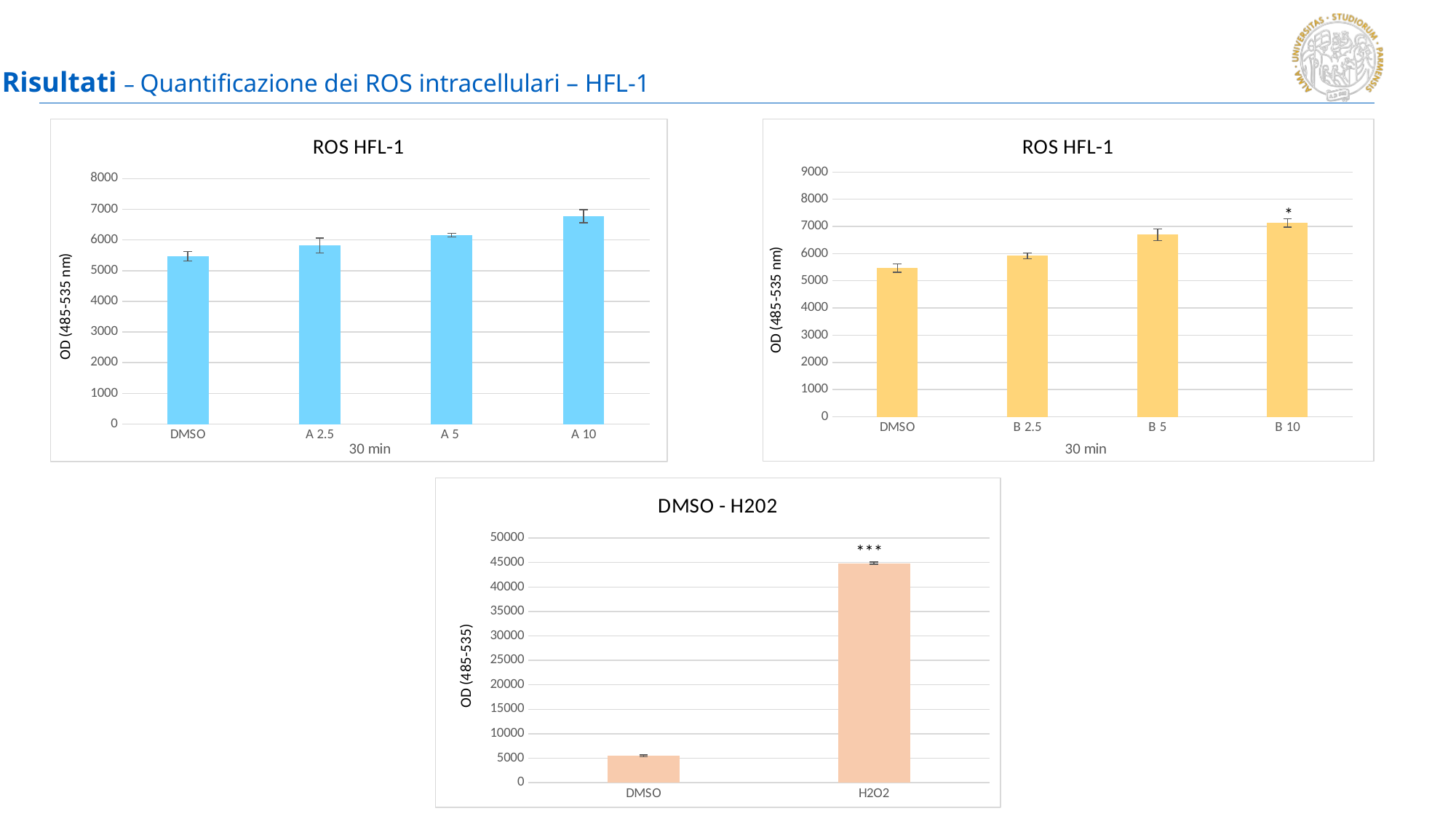
In the top-left ROS HFL-1 chart, which category has the lowest bar? DMSO What kind of chart is the DMSO - H202 chart? bar chart In the top-left ROS HFL-1 chart, is the value for DMSO greater or less than 6000? less In the top-left ROS HFL-1 chart, which category has the highest bar? A 10 In the top-right ROS HFL-1 chart, is the value for B 5 greater or less than 6000? greater In the top-left ROS HFL-1 chart, do the bar values rise or fall from DMSO to A 10? rise In the top-right ROS HFL-1 chart, which category has the highest bar? B 10 In the top-left ROS HFL-1 chart, is the value for A 10 greater or less than 6000? greater In the top-right ROS HFL-1 chart, how many categories are shown on the x axis? 4 In the DMSO - H202 chart, which category has the higher bar? H2O2 In the top-right ROS HFL-1 chart, which is larger, the value for B 2.5 or the value for B 5? B 5